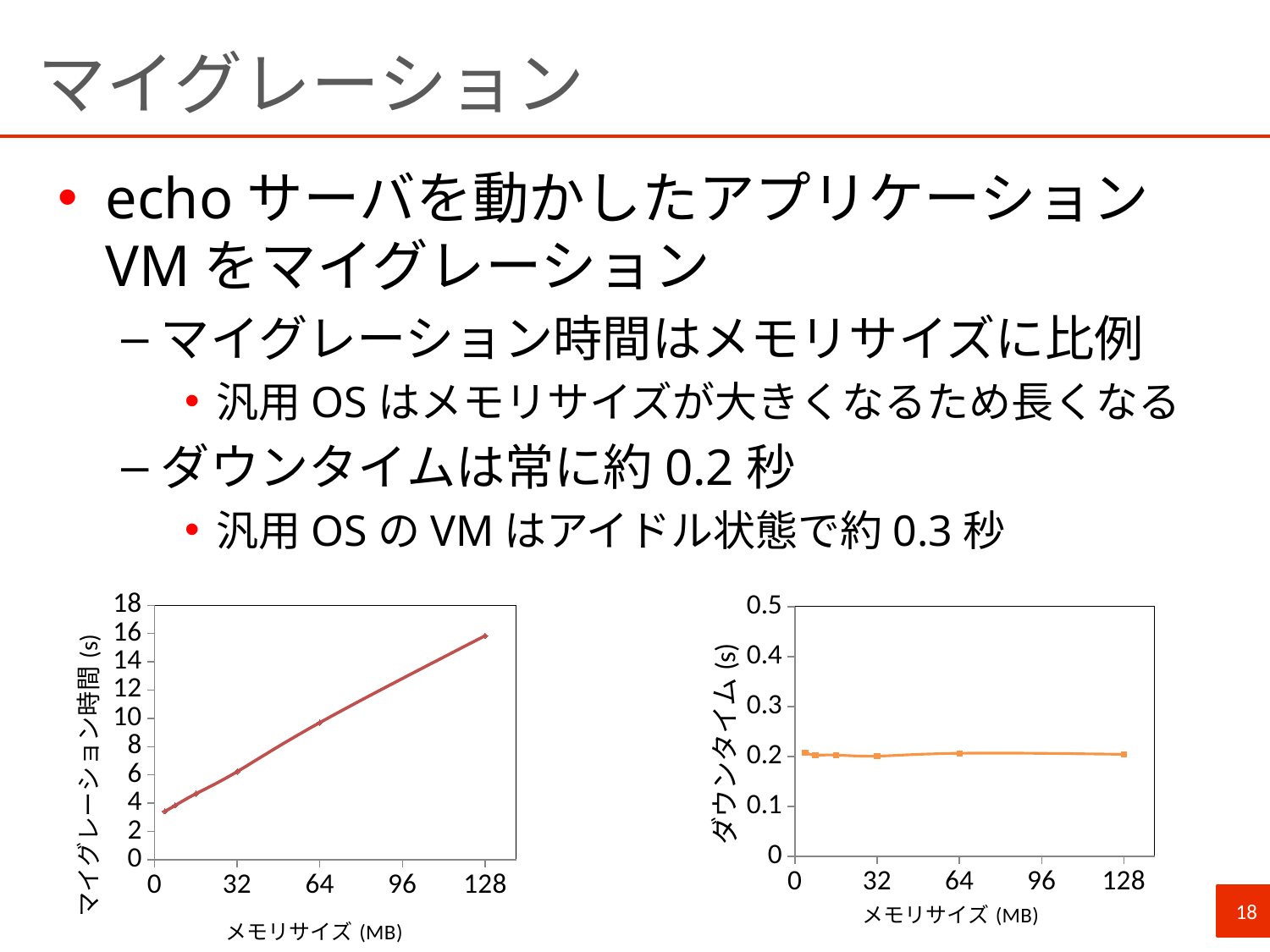
In the right chart, is the downtime at 64 MB greater or less than 0.1 s? greater What kind of chart is the left chart (マイグレーション時間)? line chart In the left chart, is the migration time at 128 MB greater or less than 14 s? greater What is the y-axis label of the right chart? ダウンタイム (s) In the left chart, does the migration time rise or fall as memory size increases along the x axis? rise What is the x-axis label of the left chart? メモリサイズ (MB) What kind of chart is the right chart (ダウンタイム)? line chart In the left chart, at which memory size is the migration time highest? 128 MB In the right chart, is the downtime at 128 MB greater or less than 0.3 s? less In the right chart, does the downtime rise, fall, or stay roughly flat as memory size increases? stays roughly flat